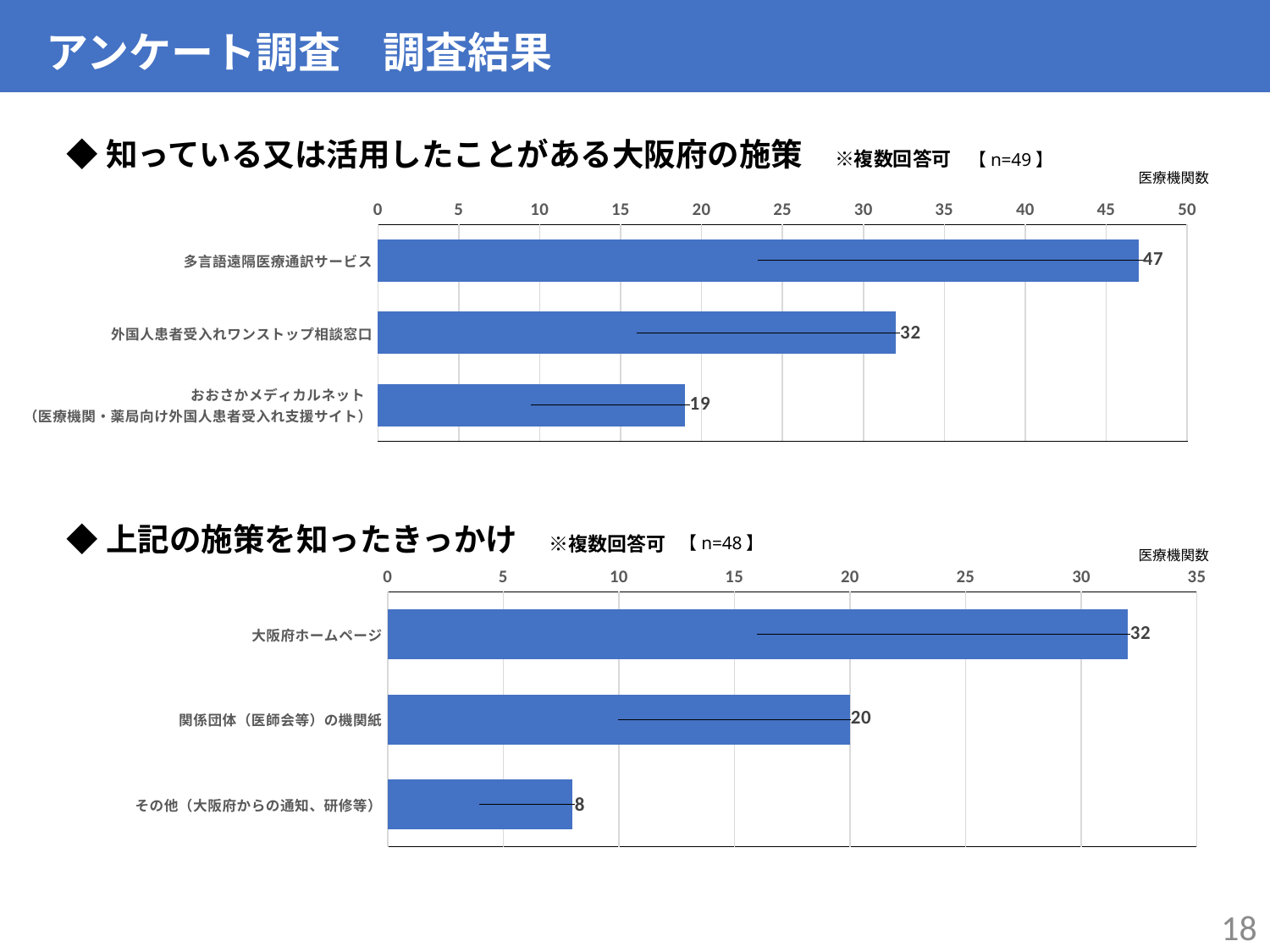
In the top chart (知っている又は活用したことがある大阪府の施策), what is the value for 多言語遠隔医療通訳サービス? 47 In the top chart (知っている又は活用したことがある大阪府の施策), which category has the lowest value? おおさかメディカルネット（医療機関・薬局向け外国人患者受入れ支援サイト） In the bottom chart (上記の施策を知ったきっかけ), which is larger: 関係団体（医師会等）の機関紙 or その他（大阪府からの通知、研修等）? 関係団体（医師会等）の機関紙 What kind of chart is the bottom chart (上記の施策を知ったきっかけ)? bar chart In the top chart (知っている又は活用したことがある大阪府の施策), what is the difference between 多言語遠隔医療通訳サービス and 外国人患者受入れワンストップ相談窓口? 15 In the bottom chart (上記の施策を知ったきっかけ), which category has the highest value? 大阪府ホームページ In the top chart (知っている又は活用したことがある大阪府の施策), how many categories are shown? 3 In the bottom chart (上記の施策を知ったきっかけ), what is the value for 大阪府ホームページ? 32 In the bottom chart (上記の施策を知ったきっかけ), what is the difference between 関係団体（医師会等）の機関紙 and その他（大阪府からの通知、研修等）? 12 In the bottom chart (上記の施策を知ったきっかけ), what is the value for その他（大阪府からの通知、研修等）? 8 In the top chart (知っている又は活用したことがある大阪府の施策), what is the value for 外国人患者受入れワンストップ相談窓口? 32 In the top chart (知っている又は活用したことがある大阪府の施策), is the value for おおさかメディカルネット greater or less than 20? less